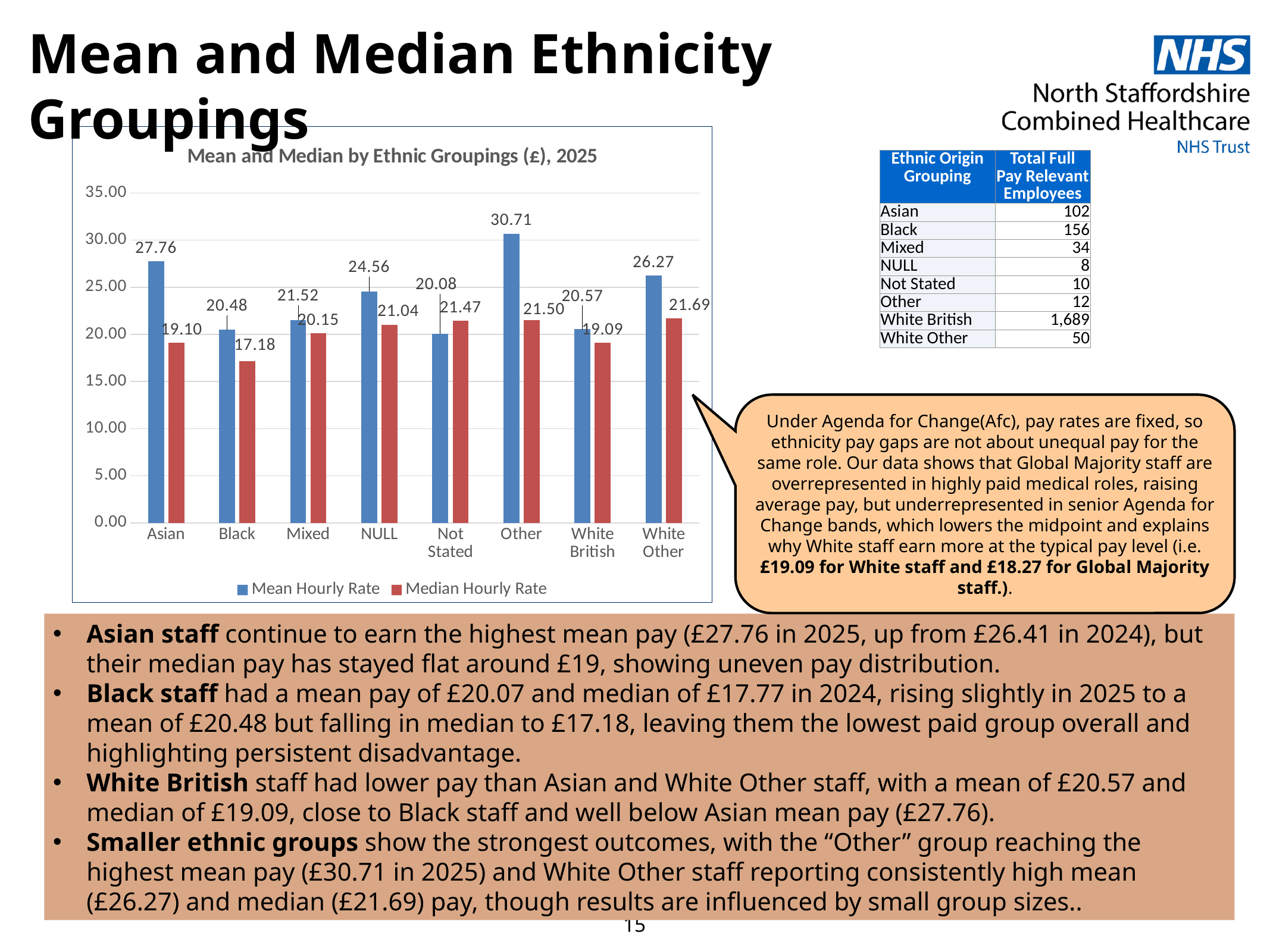
What is the Mean Hourly Rate for Asian staff? 27.76 What is the Median Hourly Rate for Black staff? 17.18 Which has the higher Mean Hourly Rate, NULL or White Other? White Other Which ethnic grouping has the lowest Median Hourly Rate? Black What is the difference between the Mean Hourly Rate for Other and for White British? 10.14 How many series does the chart legend list? 2 Which ethnic grouping has the highest Mean Hourly Rate? Other How many ethnic groupings are shown on the x axis of the chart? 8 What is the difference between the Mean Hourly Rate and the Median Hourly Rate for Asian staff? 8.66 What type of chart is shown on the slide? Bar chart What is the Median Hourly Rate for White Other staff? 21.69 For Not Stated, which is larger, the Mean Hourly Rate or the Median Hourly Rate? Median Hourly Rate